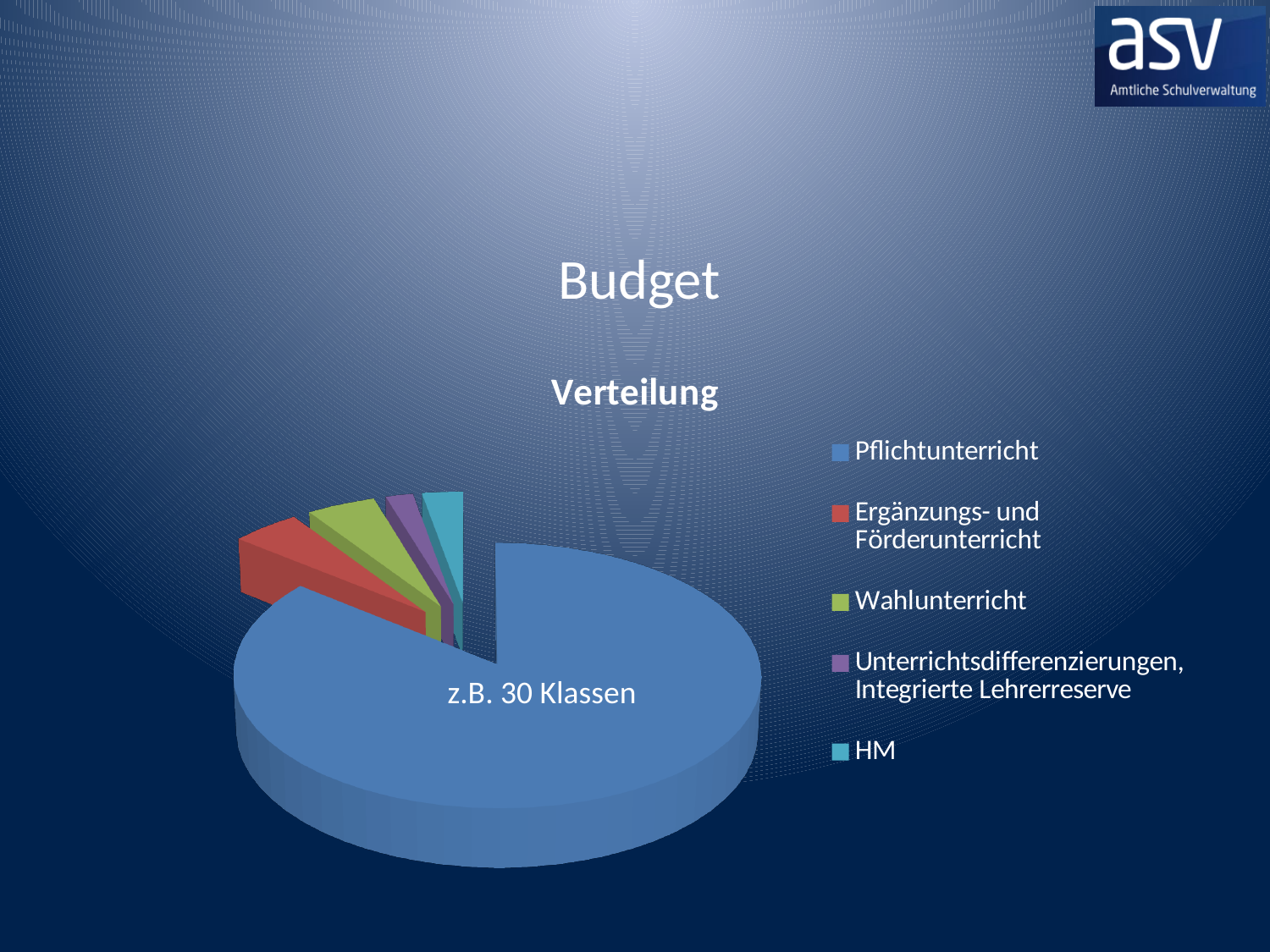
Which slice is larger, Pflichtunterricht or Wahlunterricht? Pflichtunterricht How many categories does the pie chart's legend list? 5 Which category has the largest slice of the pie? Pflichtunterricht Is the Pflichtunterricht slice larger or smaller than all the other slices combined? larger What is the title of the chart? Verteilung Which legend entry is listed last in the chart's legend? HM Which slice is larger, Ergänzungs- und Förderunterricht or HM? Ergänzungs- und Förderunterricht What text label is printed on the largest slice of the pie? z.B. 30 Klassen What kind of chart is shown on the slide? pie chart